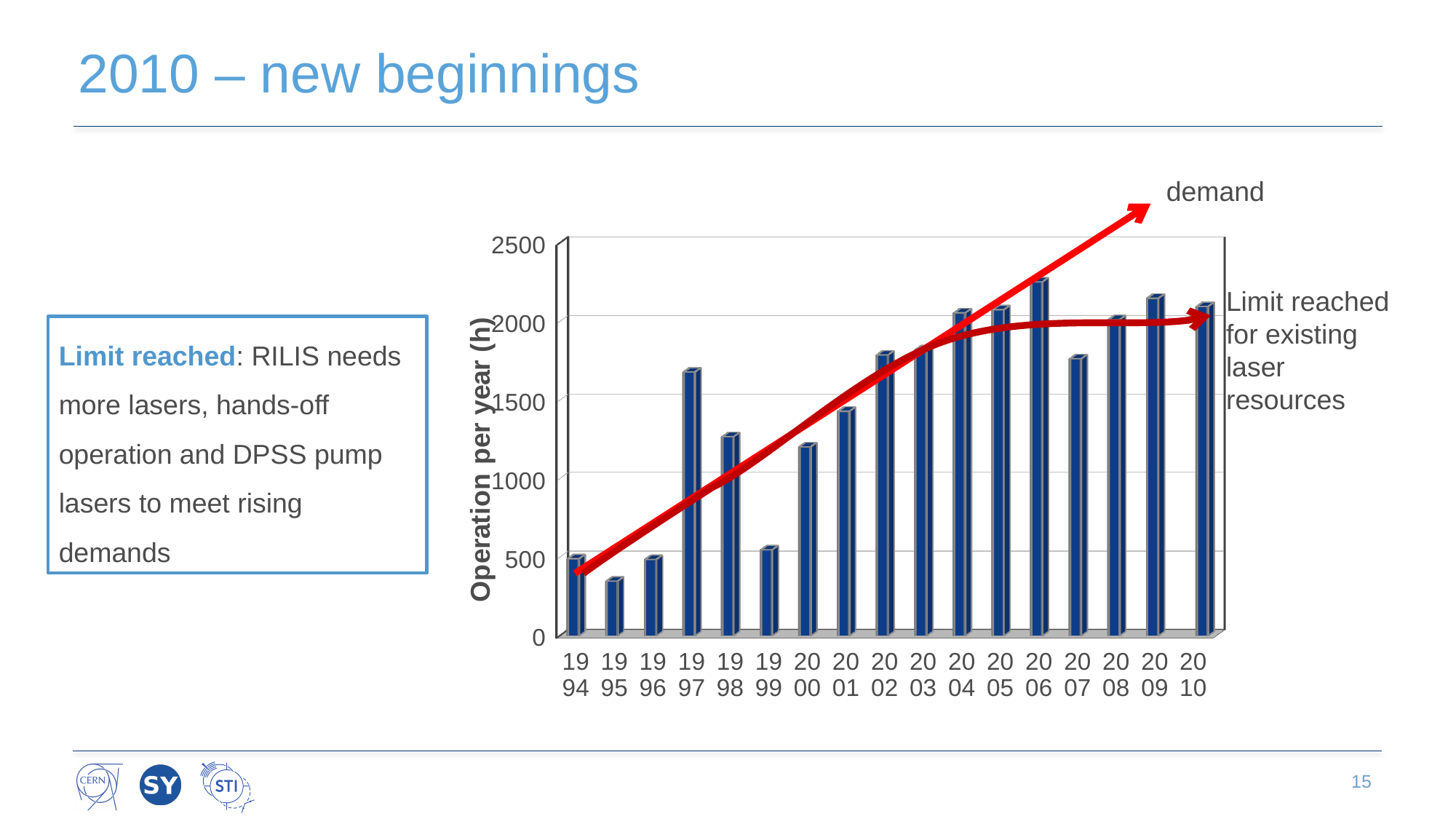
Is the value for 2001 greater or less than 1500? less How many years are plotted on the x axis of the chart? 17 Is the value for 1997 greater or less than 1500? greater Which year has the highest operation per year? 2006 Is the value for 1995 greater or less than 500? less What is the title of the vertical axis of the chart? Operation per year (h) What kind of chart is shown on the slide? bar chart Which year has the lowest operation per year? 1995 Overall, do the values rise or fall from 1994 to 2010? rise Which year has the larger value, 1997 or 1998? 1997